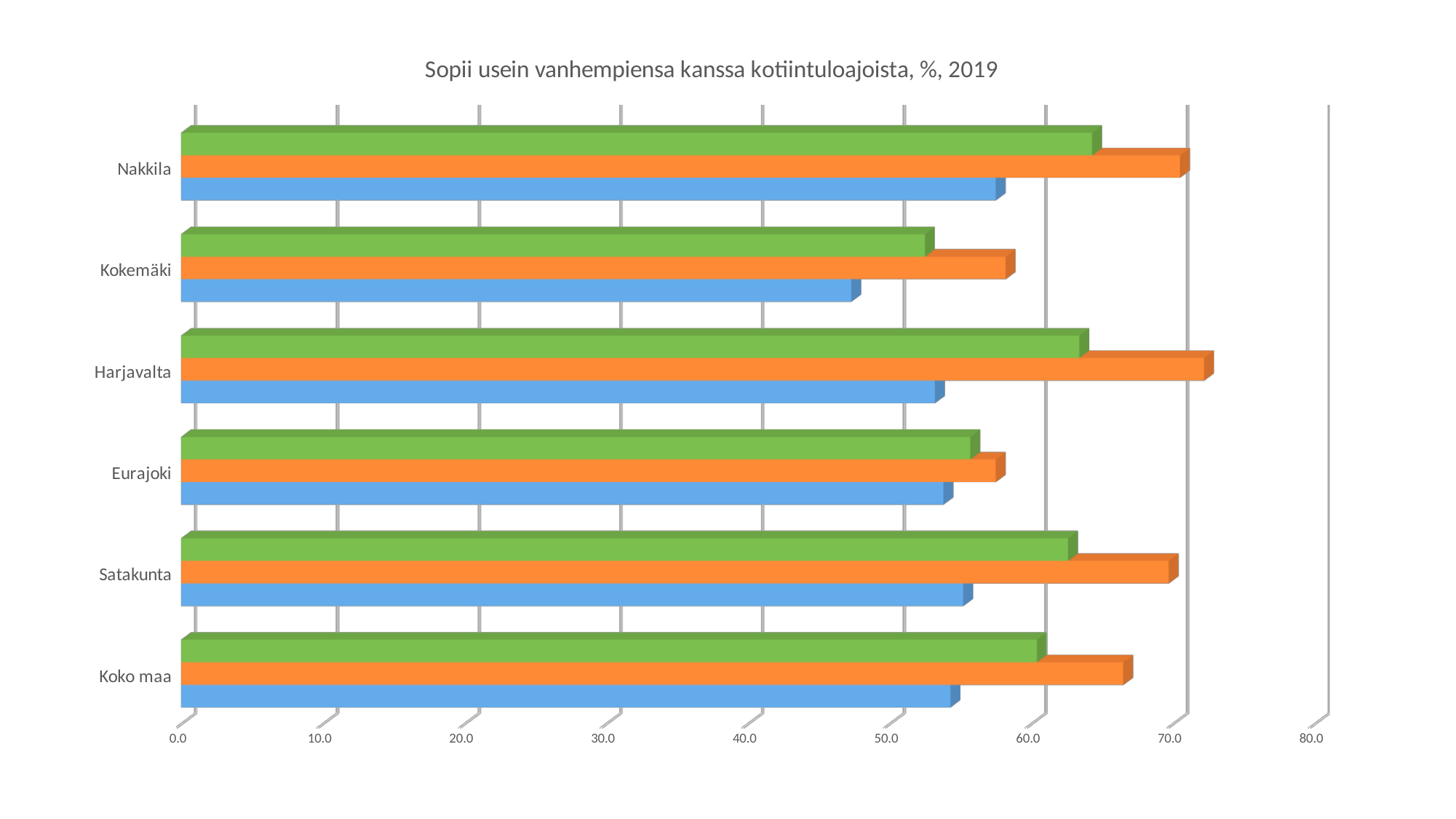
How many bars are plotted for each category? 3 What kind of chart is shown on the slide? bar chart Is the value of the orange bar for Eurajoki greater or less than 60.0? less Is the value of the green bar for Nakkila greater or less than 60.0? greater What is the title of the chart? Sopii usein vanhempiensa kanssa kotiintuloajoista, %, 2019 Is the value of the blue bar for Kokemäki greater or less than 50.0? less Which is larger, the orange bar for Nakkila or the orange bar for Kokemäki? Nakkila Which category has the lowest value for the green bar? Kokemäki Which category has the lowest value for the blue bar? Kokemäki How many categories (areas) are shown on the chart? 6